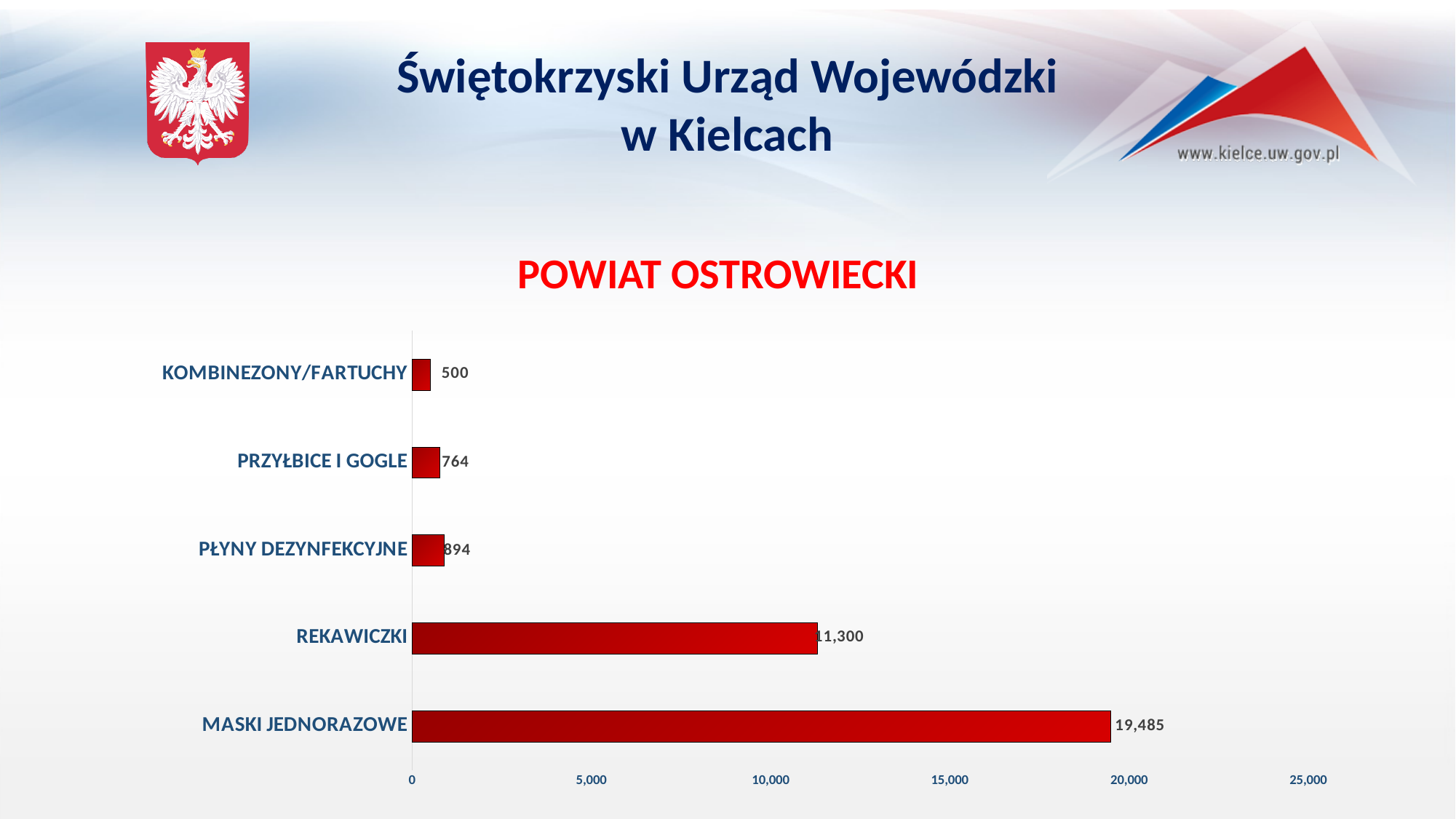
How many categories are shown in the chart? 5 What kind of chart is shown on the slide? bar chart What is the value for PŁYNY DEZYNFEKCYJNE? 894 What is the value for PRZYŁBICE I GOGLE? 764 What is the value for REKAWICZKI? 11,300 What is the value for KOMBINEZONY/FARTUCHY? 500 What is the value for MASKI JEDNORAZOWE? 19,485 Is the value for REKAWICZKI greater or less than 10,000? greater What is the difference between the values for MASKI JEDNORAZOWE and REKAWICZKI? 8,185 Which category has the lowest value? KOMBINEZONY/FARTUCHY Which category has the highest value? MASKI JEDNORAZOWE Which is larger, the value for PRZYŁBICE I GOGLE or the value for PŁYNY DEZYNFEKCYJNE? PŁYNY DEZYNFEKCYJNE